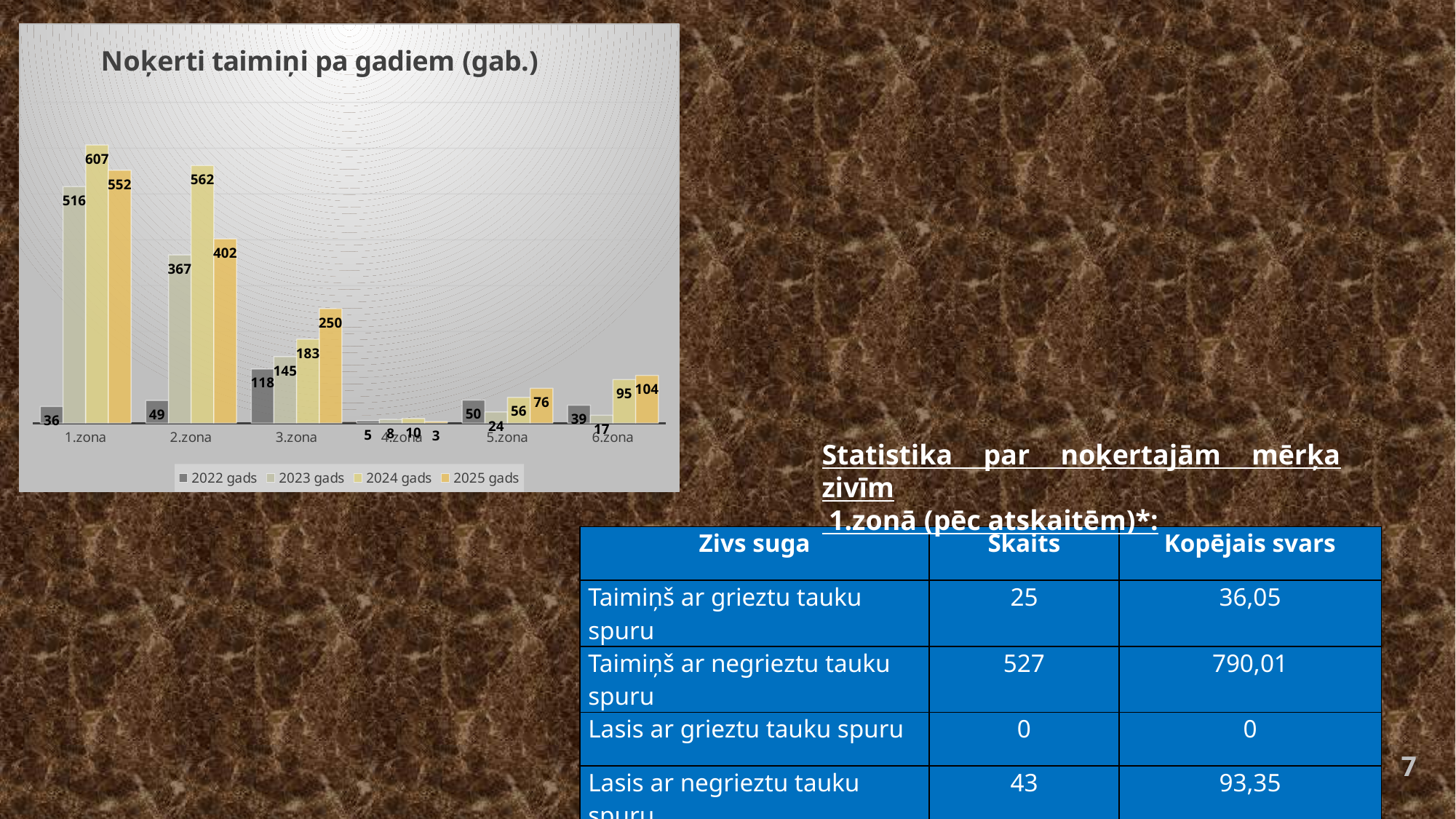
What kind of chart is shown on the slide? bar chart How many series does the chart legend list? 4 Which zone has the highest value for 2025 gads? 1.zona How many zones (categories) are shown on the x axis of the chart? 6 What is the title of the chart? Noķerti taimiņi pa gadiem (gab.) Do the values for 3.zona rise or fall from 2022 gads to 2025 gads? rise Which zone has the lowest value for 2022 gads? 4.zona What is the value for 2023 gads in 2.zona? 367 What is the value for 2024 gads in 1.zona? 607 What is the difference between the 2024 gads and 2023 gads values in 1.zona? 91 Which is larger in 5.zona: the value for 2022 gads or the value for 2023 gads? 2022 gads What is the value for 2025 gads in 3.zona? 250